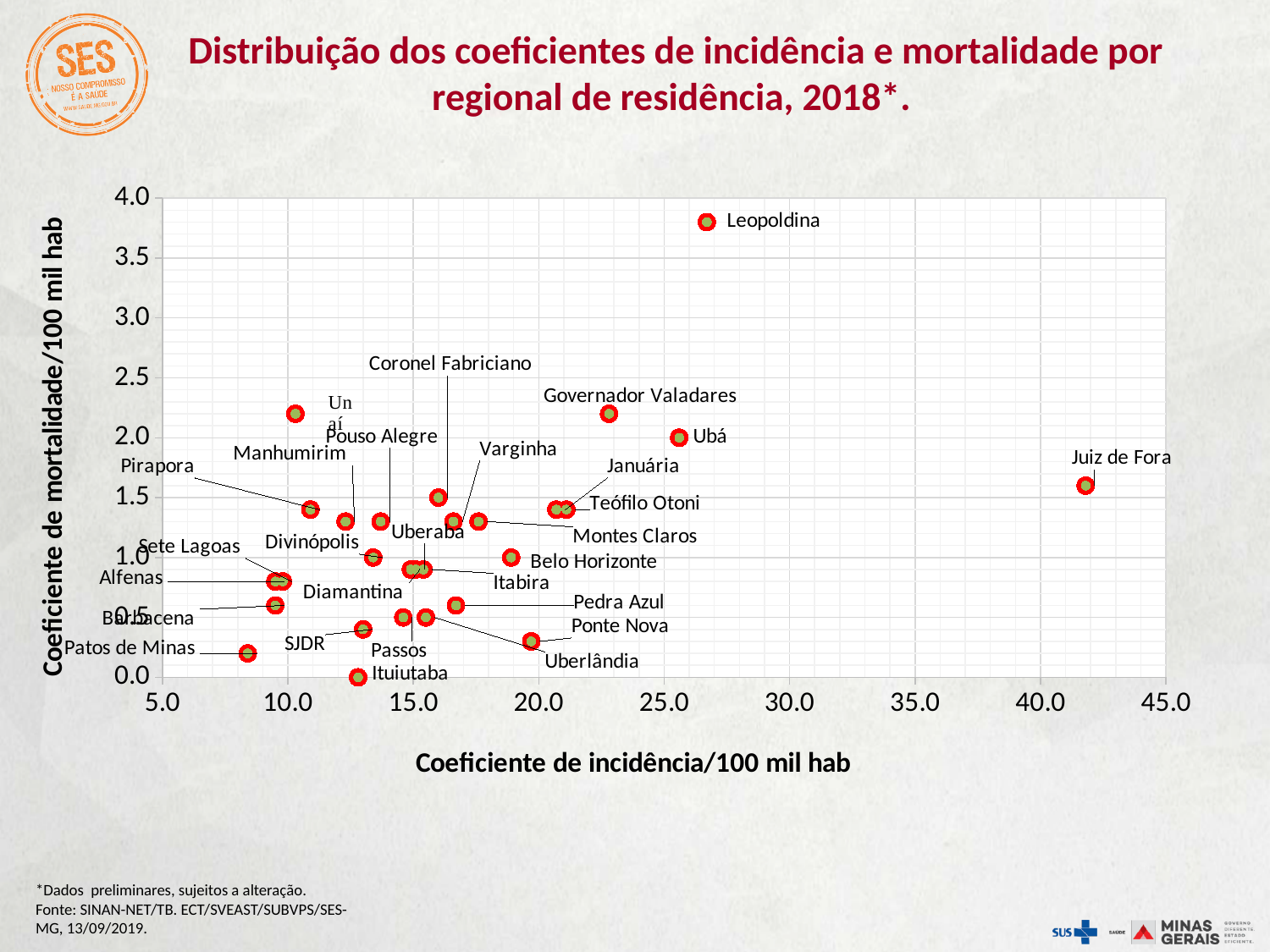
Which regional has the lowest coefficient of incidence? Patos de Minas Is the coefficient of incidence for Juiz de Fora greater or less than 40.0? greater What kind of chart is shown on the slide? Scatter chart Is the coefficient of incidence for Ubá greater or less than 25.0? greater Is the coefficient of mortality for Leopoldina greater or less than 3.5? greater Which regional has the highest coefficient of mortality? Leopoldina What is the label of the horizontal axis of the chart? Coeficiente de incidência/100 mil hab Which regional has the highest coefficient of incidence? Juiz de Fora Which regional has the lowest coefficient of mortality? Ituiutaba Which has a higher coefficient of incidence, Juiz de Fora or Ubá? Juiz de Fora Which has a higher coefficient of mortality, Leopoldina or Governador Valadares? Leopoldina